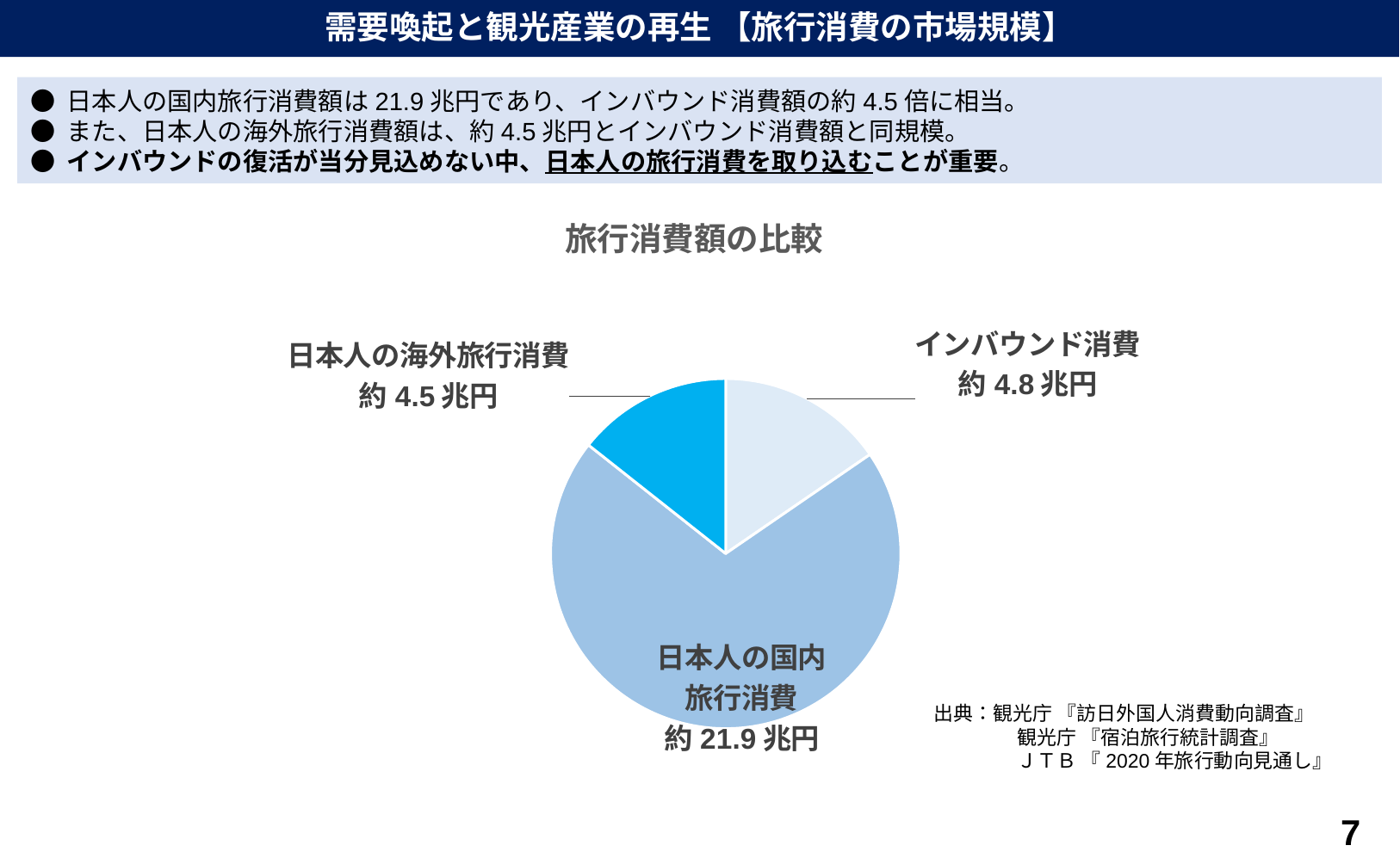
What kind of chart is shown on the slide? pie chart How many slices does the pie chart have? 3 Which category has the largest slice of the pie? 日本人の国内旅行消費 What is the difference between インバウンド消費 and 日本人の海外旅行消費? 0.3兆円 What is the title of the chart? 旅行消費額の比較 What is the value shown for 日本人の海外旅行消費? 約4.5兆円 Which is larger, インバウンド消費 or 日本人の海外旅行消費? インバウンド消費 What is the difference between 日本人の国内旅行消費 and インバウンド消費? 17.1兆円 Which slice is drawn in the brightest blue colour? 日本人の海外旅行消費 What is the value shown for 日本人の国内旅行消費? 約21.9兆円 Which category has the smallest slice of the pie? 日本人の海外旅行消費 What is the value shown for インバウンド消費? 約4.8兆円